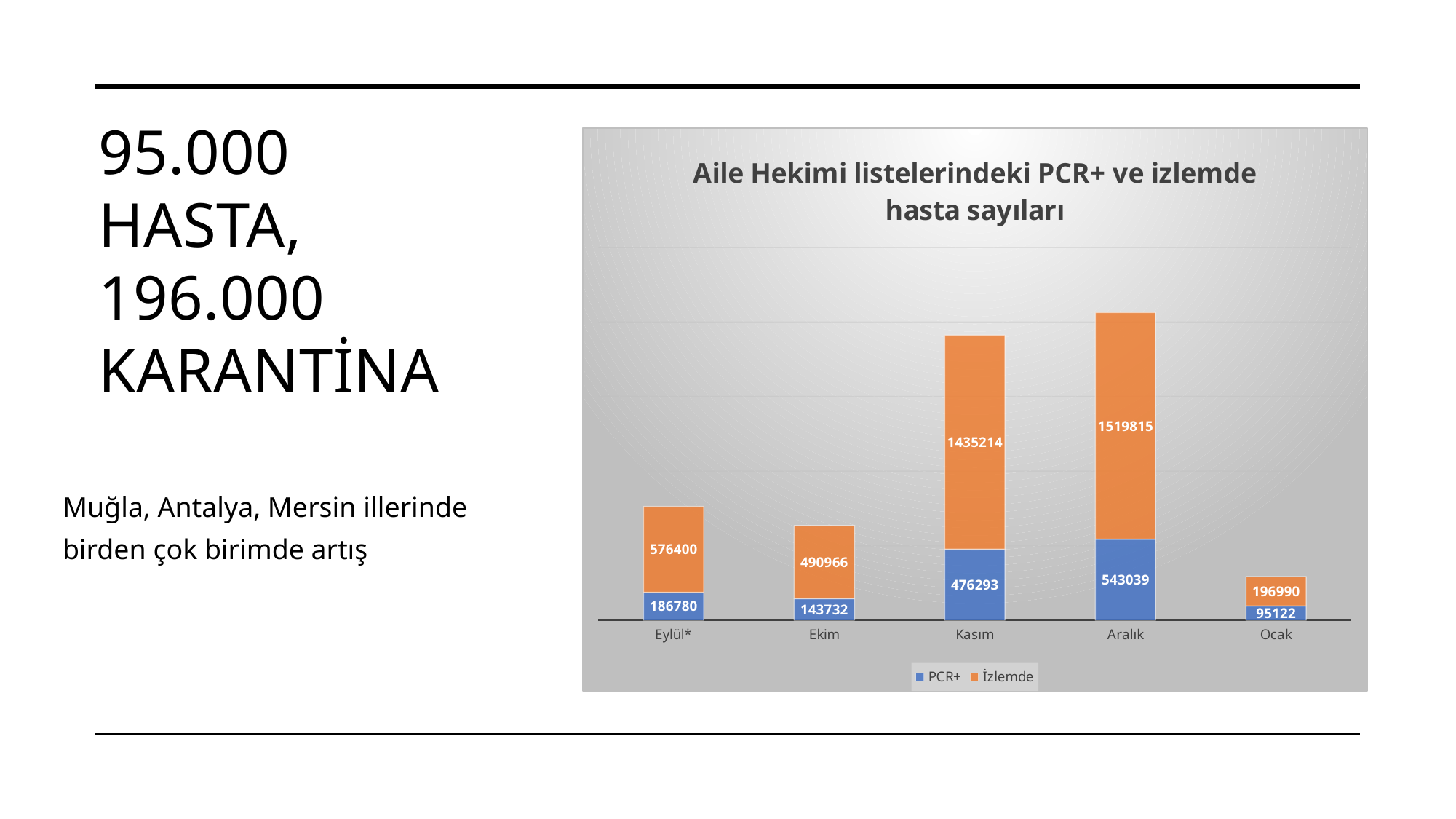
Which month has the lowest PCR+ value? Ocak What kind of chart is shown on the slide? Stacked bar chart What is the title of the chart? Aile Hekimi listelerindeki PCR+ ve izlemde hasta sayıları Which is larger, the PCR+ value for Eylül* or the PCR+ value for Ekim? Eylül* What is the PCR+ value for Kasım? 476293 What is the İzlemde value for Eylül*? 576400 What is the difference between the İzlemde values for Aralık and Kasım? 84601 How many months are shown on the x axis? 5 Which month has the highest İzlemde value? Aralık How many series does the legend list? 2 What is the total of the stacked bar for Ocak? 292112 What is the PCR+ value for Ocak? 95122